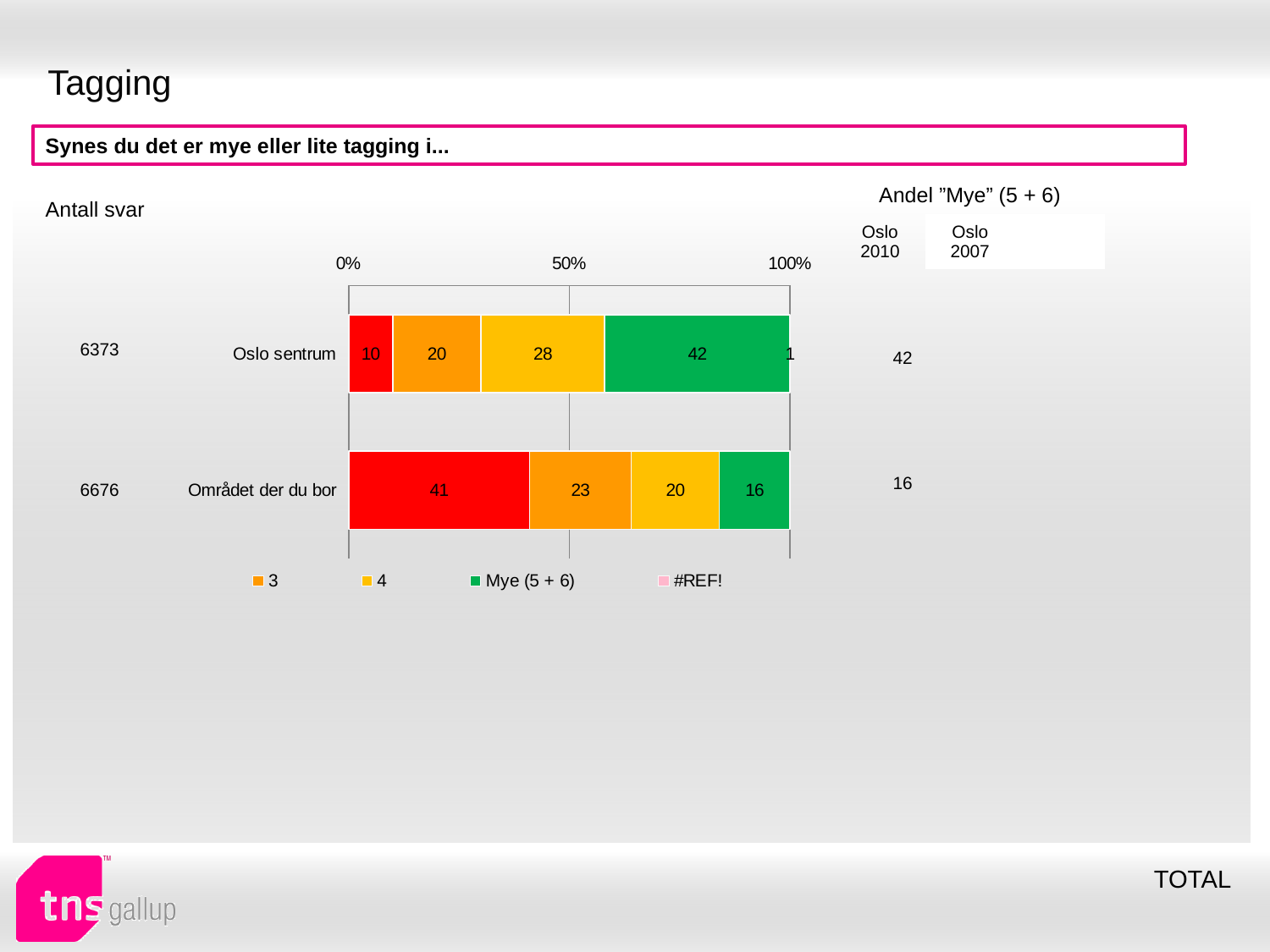
What question text is shown in the box above the chart? Synes du det er mye eller lite tagging i... What is the difference between the "4" segment values for Oslo sentrum and Området der du bor? 8 What is the value of the "Mye (5 + 6)" segment for Oslo sentrum? 42 What is the difference between the "Mye (5 + 6)" values for Oslo sentrum and Området der du bor? 26 What is the value of the "3" segment for Området der du bor? 23 What is the "Antall svar" (number of responses) shown for Oslo sentrum? 6373 What is the value of the "4" segment for Oslo sentrum? 28 What kind of chart is shown on the slide? Stacked bar chart How many categories (bars) does the chart show? 2 What is the value of the "Mye (5 + 6)" segment for Området der du bor? 16 Which category has the larger "Mye (5 + 6)" value, Oslo sentrum or Området der du bor? Oslo sentrum Which category has the larger value for the "3" segment? Området der du bor